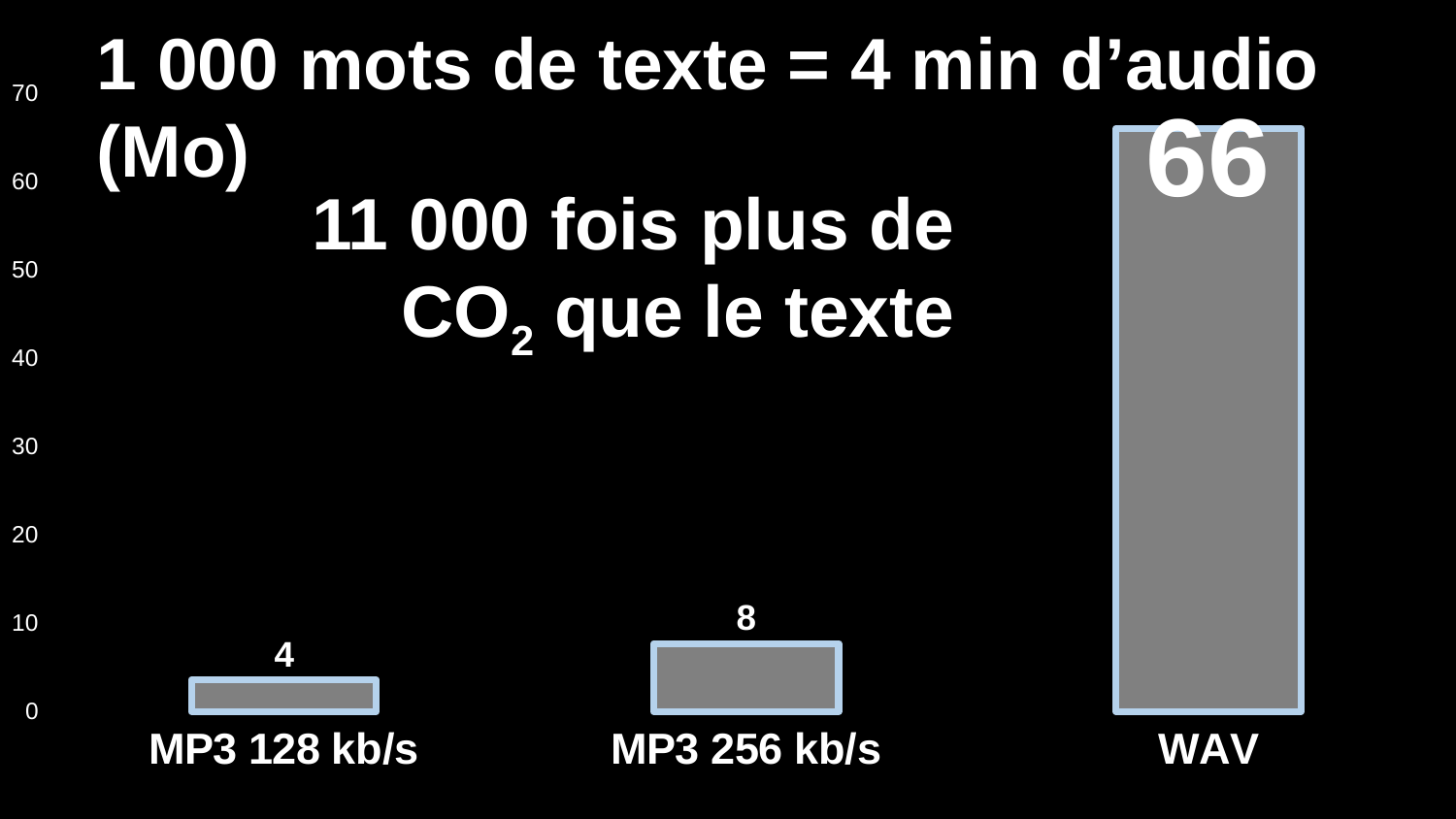
How many categories are shown on the chart? 3 What is the difference between the values for MP3 256 kb/s and MP3 128 kb/s? 4 What is the value for MP3 256 kb/s? 8 What is the value for MP3 128 kb/s? 4 What is the value for WAV? 66 Which category has the lowest value? MP3 128 kb/s Which category has the highest value? WAV What is the title of the chart? 1 000 mots de texte = 4 min d’audio (Mo) Is the value for WAV greater or less than 60? greater What is the difference between the values for WAV and MP3 256 kb/s? 58 Which is larger, the value for MP3 256 kb/s or the value for MP3 128 kb/s? MP3 256 kb/s What kind of chart is shown on the slide? bar chart